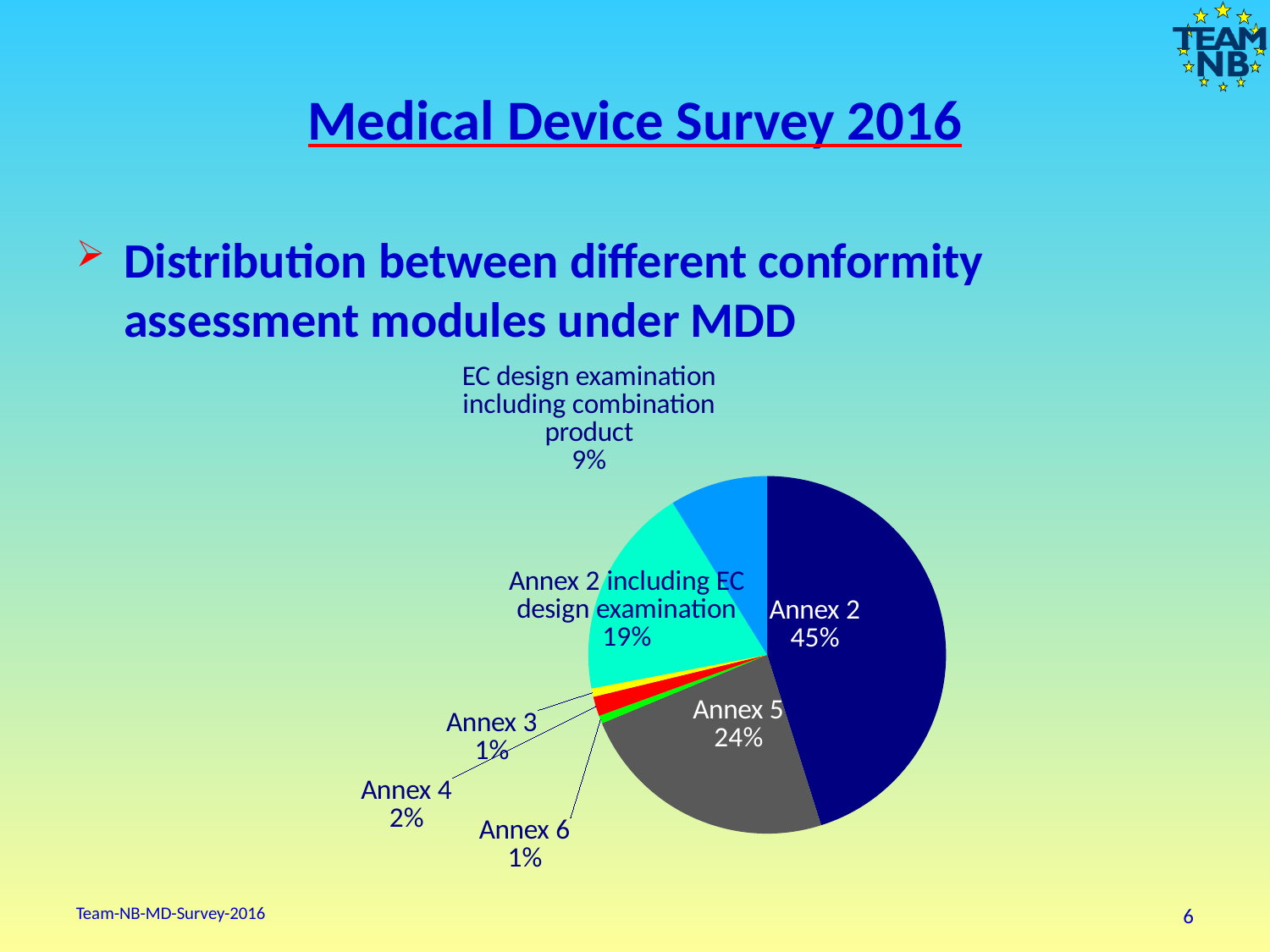
What is the difference in percentage points between Annex 2 and Annex 5? 21 percentage points Which category has the largest slice of the pie? Annex 2 Which is larger, the share for Annex 5 or the share for 'Annex 2 including EC design examination'? Annex 5 What kind of chart is shown on the slide? Pie chart What share of the pie does Annex 4 represent? 2% What is the combined share of Annex 3 and Annex 6? 2% What colour is the Annex 5 slice? Grey What share of the pie does 'EC design examination including combination product' represent? 9% How many slices does the pie chart have? 7 What share of the pie does Annex 2 represent? 45%